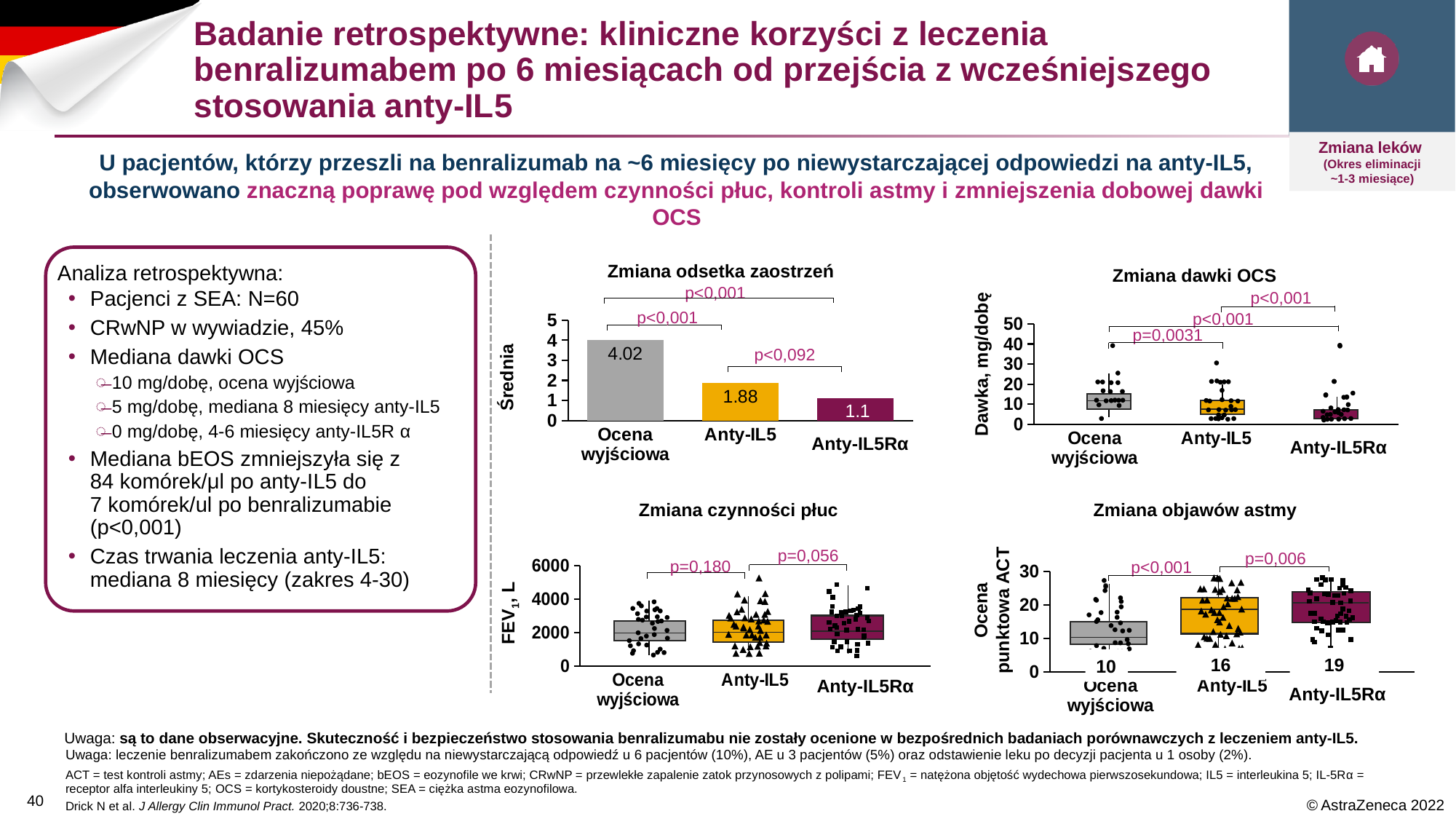
In the chart titled "Zmiana odsetka zaostrzeń", what is the value for Anty-IL5? 1.88 In the chart titled "Zmiana odsetka zaostrzeń", what is the difference between the values for Ocena wyjściowa and Anty-IL5? 2.14 In the chart titled "Zmiana objawów astmy", what is the difference between the printed values for Anty-IL5Rα and Ocena wyjściowa? 9 In the chart titled "Zmiana odsetka zaostrzeń", what p-value is shown between Ocena wyjściowa and Anty-IL5? p<0,001 In the chart titled "Zmiana odsetka zaostrzeń", which category has the highest value? Ocena wyjściowa In the chart titled "Zmiana odsetka zaostrzeń", do the values rise or fall from left to right along the x axis? fall In the chart titled "Zmiana odsetka zaostrzeń", what is the value for Ocena wyjściowa? 4.02 In the chart titled "Zmiana odsetka zaostrzeń", what is the value for Anty-IL5Rα? 1.1 In the chart titled "Zmiana dawki OCS", is the median value for Anty-IL5Rα greater or less than 10? less In the chart titled "Zmiana dawki OCS", how many categories are shown on the x axis? 3 What kind of chart is the one titled "Zmiana odsetka zaostrzeń"? bar chart In the chart titled "Zmiana objawów astmy", what value is printed for Anty-IL5Rα? 19